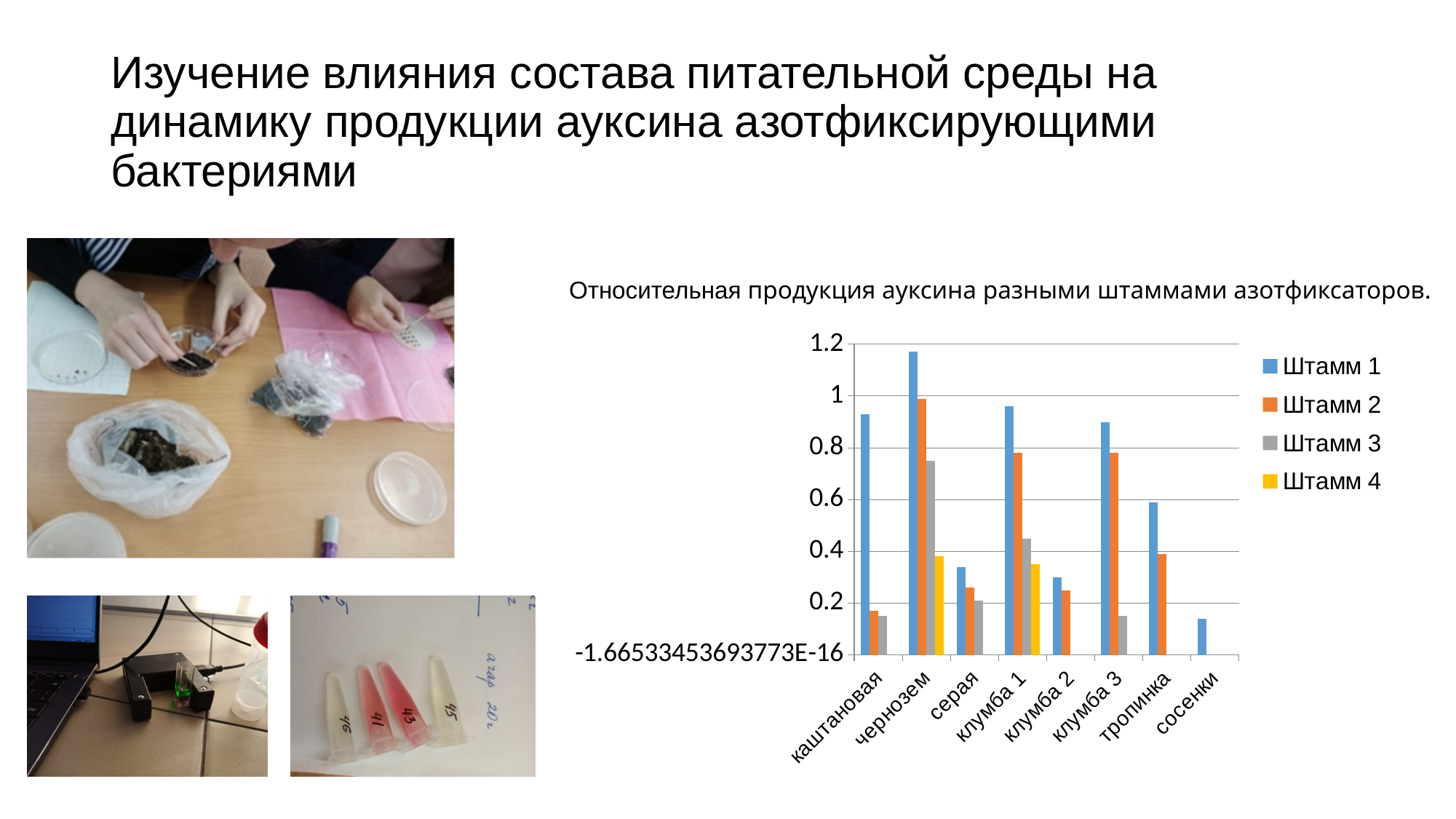
Which is larger in клумба 1: the value for Штамм 1 or the value for Штамм 3? Штамм 1 Is the value for Штамм 1 in чернозем greater or less than 1? greater Which series is shown in yellow in the chart legend? Штамм 4 Which category has the lowest value for Штамм 1? сосенки Is the value for Штамм 2 in каштановая greater or less than 0.2? less Is the value for Штамм 1 in тропинка greater or less than 0.4? greater How many categories are shown along the x axis of the chart? 8 What kind of chart is shown on the slide? bar chart Which is larger: the value for Штамм 1 in серая or the value for Штамм 1 in клумба 3? клумба 3 Which category has the highest value for Штамм 1? чернозем How many series does the chart legend list? 4 What is the title of the chart? Относительная продукция ауксина разными штаммами азотфиксаторов.